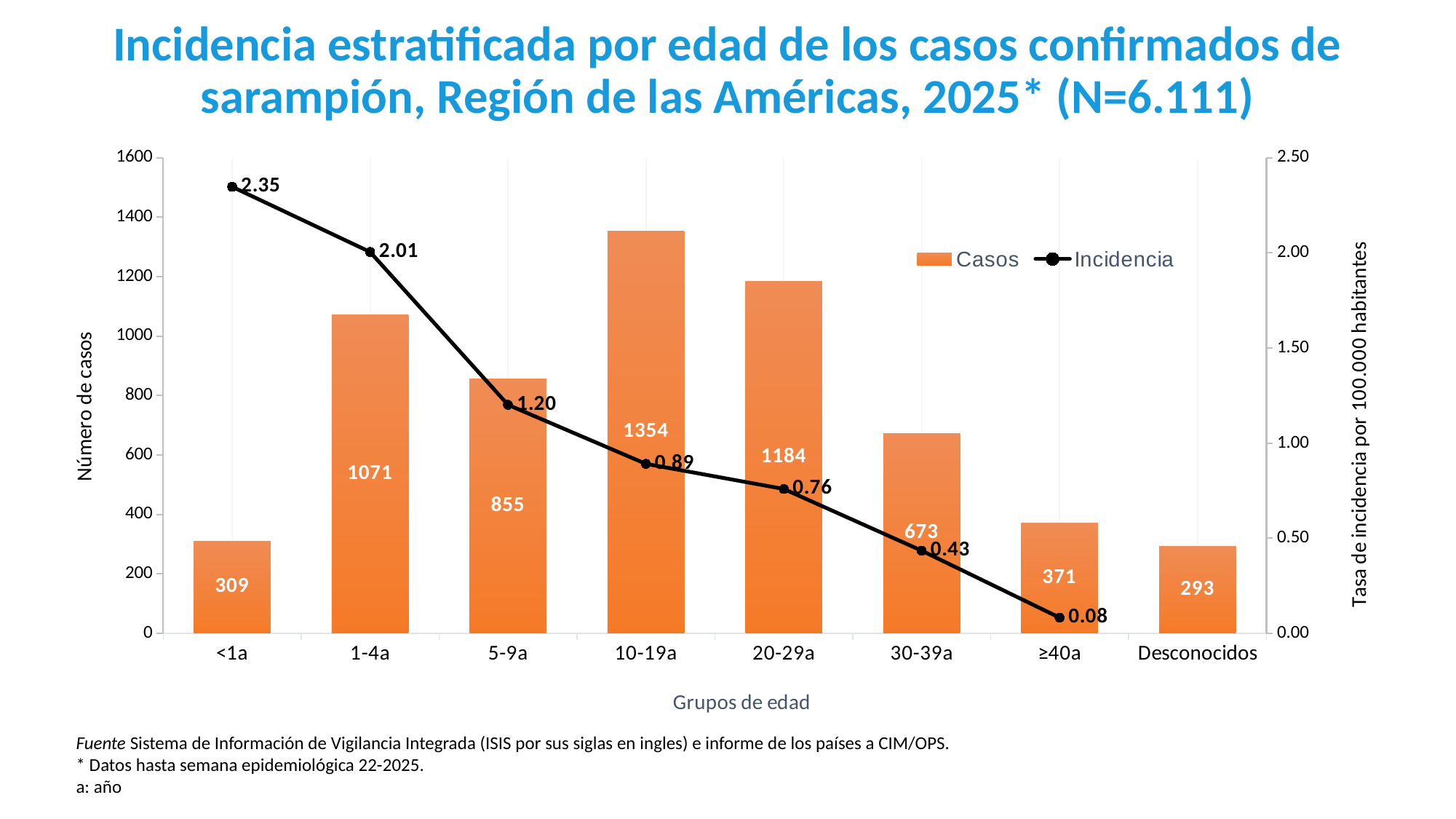
How many confirmed measles cases (Casos) are shown for the 10-19a age group? 1354 What is the difference in cases between the 10-19a and 20-29a age groups? 170 Which has more cases, the 1-4a group or the 5-9a group? 1-4a What is the label of the right-hand vertical axis? Tasa de incidencia por 100.000 habitantes How many cases are shown for the Desconocidos category? 293 How many series does the legend list? 2 How many age-group categories are shown on the x axis? 8 Does the incidence line rise or fall from <1a to ≥40a? fall Which age group has the lowest incidence rate? ≥40a What is the incidence rate (Incidencia) for the <1a age group? 2.35 Is the number of cases for the 30-39a group greater or less than 600? greater Which age group has the highest number of cases? 10-19a